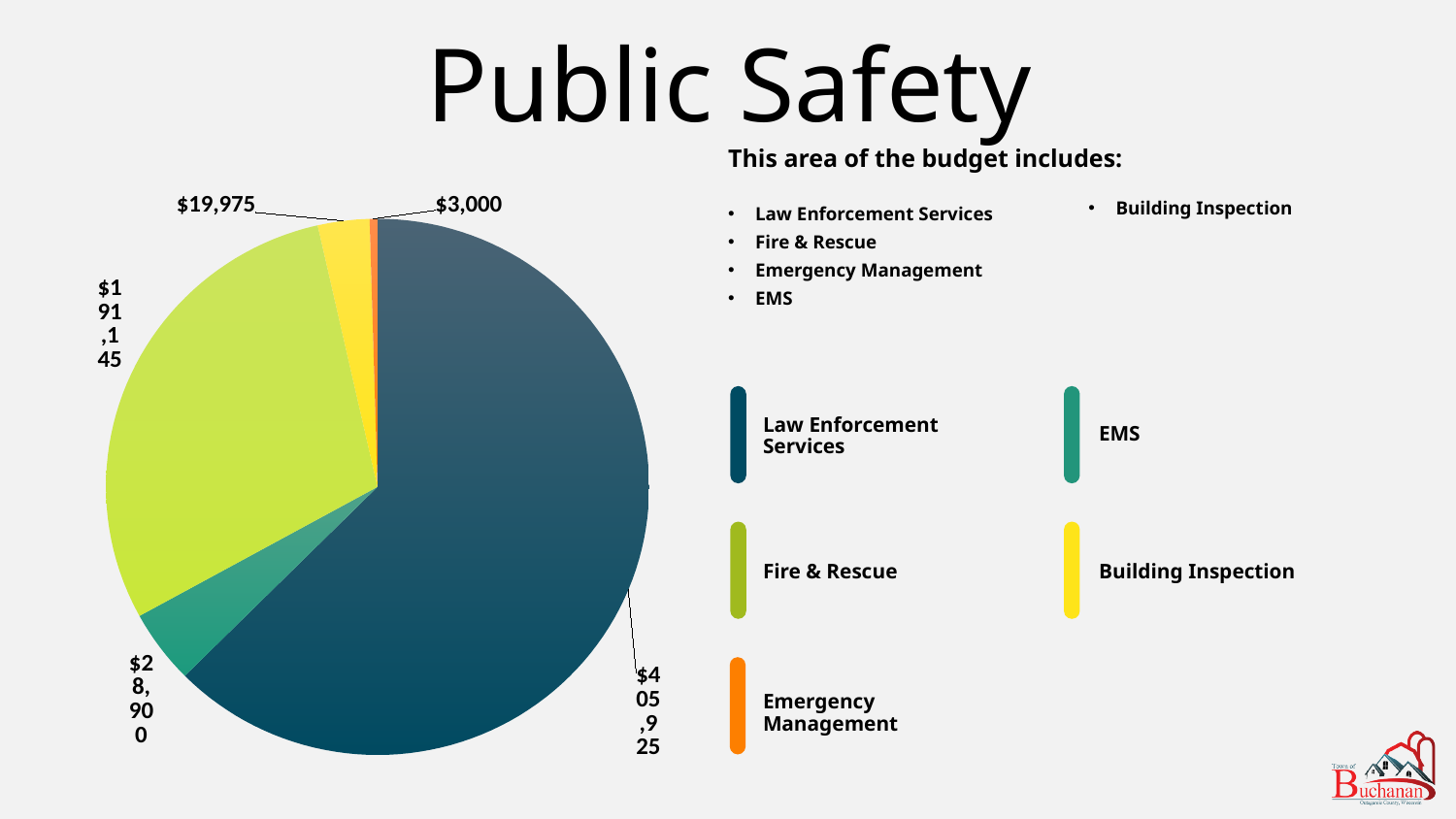
What is the value for Law Enforcement Services? $405,925 What is the difference between the values for EMS and Building Inspection? $8,925 Which category has the smallest slice of the pie? Emergency Management What is the value for Building Inspection? $19,975 What is the value for Emergency Management? $3,000 What is the difference between the values for Law Enforcement Services and Fire & Rescue? $214,780 What type of chart is shown on the slide? Pie chart Which category has the largest slice of the pie? Law Enforcement Services What is the value for EMS? $28,900 What is the value for Fire & Rescue? $191,145 How many categories does the legend list? 5 Which is larger, the value for Fire & Rescue or the value for EMS? Fire & Rescue